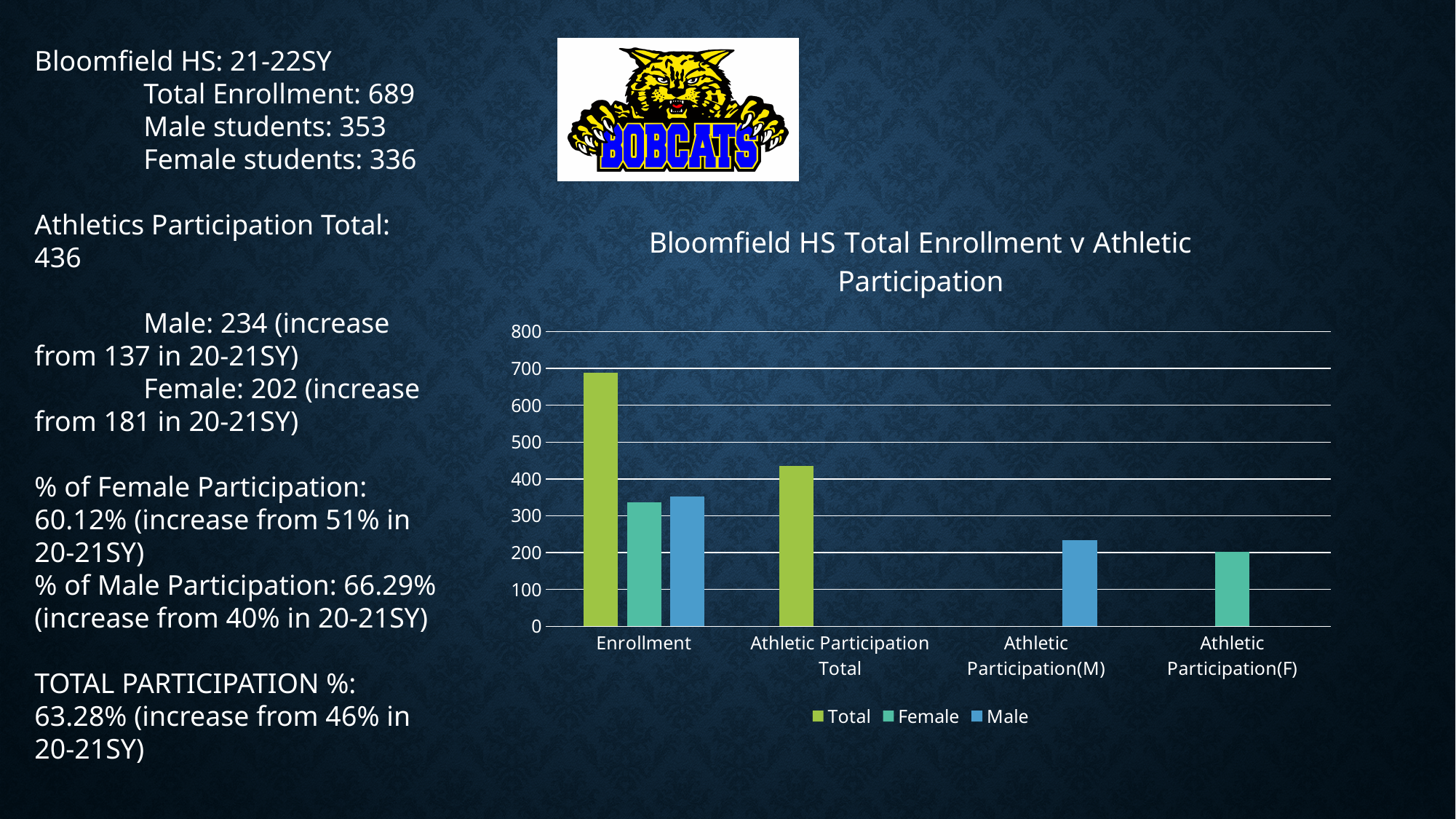
Which category has the tallest bar in the chart? Enrollment Is the Female bar for Enrollment greater or less than 300? greater How many series does the chart legend list? 3 What kind of chart is shown on the slide? bar chart Is the Total bar for Athletic Participation Total greater or less than 400? greater How many categories are shown on the x axis of the chart? 4 Is the Male bar for Athletic Participation(M) greater or less than 200? greater Which is larger: the Male bar for Athletic Participation(M) or the Female bar for Athletic Participation(F)? Athletic Participation(M) What is the title of the chart? Bloomfield HS Total Enrollment v Athletic Participation